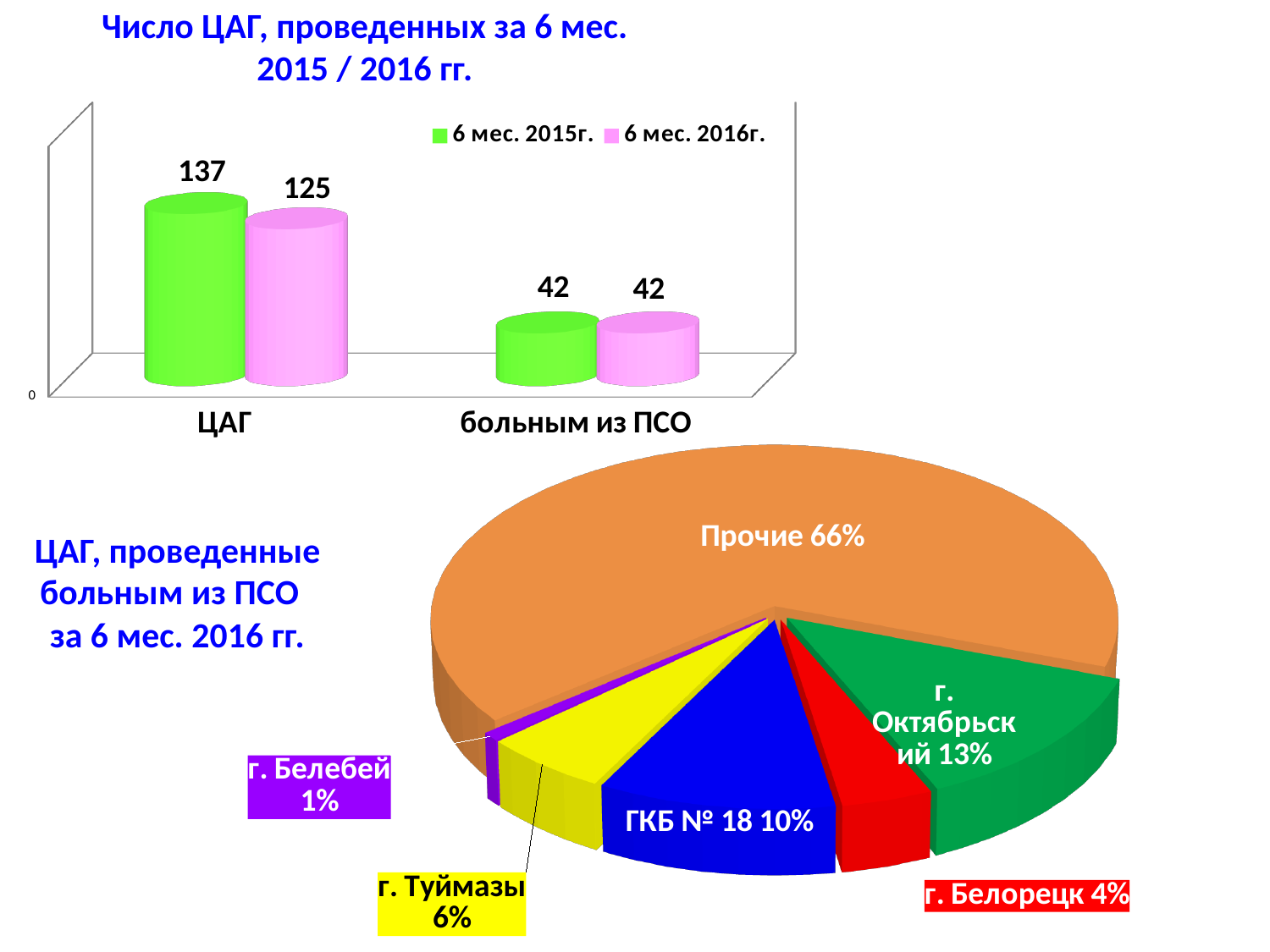
In the bar chart 'Число ЦАГ, проведенных за 6 мес. 2015 / 2016 гг.', what is the value for больным из ПСО in 6 мес. 2016г.? 42 In the pie chart 'ЦАГ, проведенные больным из ПСО за 6 мес. 2016 гг.', what share does г. Октябрьский have? 13% In the bar chart 'Число ЦАГ, проведенных за 6 мес. 2015 / 2016 гг.', what is the value for ЦАГ in 6 мес. 2015г.? 137 In the bar chart 'Число ЦАГ, проведенных за 6 мес. 2015 / 2016 гг.', what is the difference between the ЦАГ values for 6 мес. 2015г. and 6 мес. 2016г.? 12 In the pie chart 'ЦАГ, проведенные больным из ПСО за 6 мес. 2016 гг.', which slice is the smallest? г. Белебей In the bar chart 'Число ЦАГ, проведенных за 6 мес. 2015 / 2016 гг.', how many series does the legend list? 2 In the pie chart 'ЦАГ, проведенные больным из ПСО за 6 мес. 2016 гг.', what share does Прочие have? 66% In the pie chart 'ЦАГ, проведенные больным из ПСО за 6 мес. 2016 гг.', what colour is the ГКБ № 18 slice? blue In the bar chart 'Число ЦАГ, проведенных за 6 мес. 2015 / 2016 гг.', what is the value for ЦАГ in 6 мес. 2016г.? 125 In the pie chart 'ЦАГ, проведенные больным из ПСО за 6 мес. 2016 гг.', how many slices are there? 6 What kind of chart is the top chart 'Число ЦАГ, проведенных за 6 мес. 2015 / 2016 гг.'? bar chart In the bar chart 'Число ЦАГ, проведенных за 6 мес. 2015 / 2016 гг.', which is larger for ЦАГ: 6 мес. 2015г. or 6 мес. 2016г.? 6 мес. 2015г.